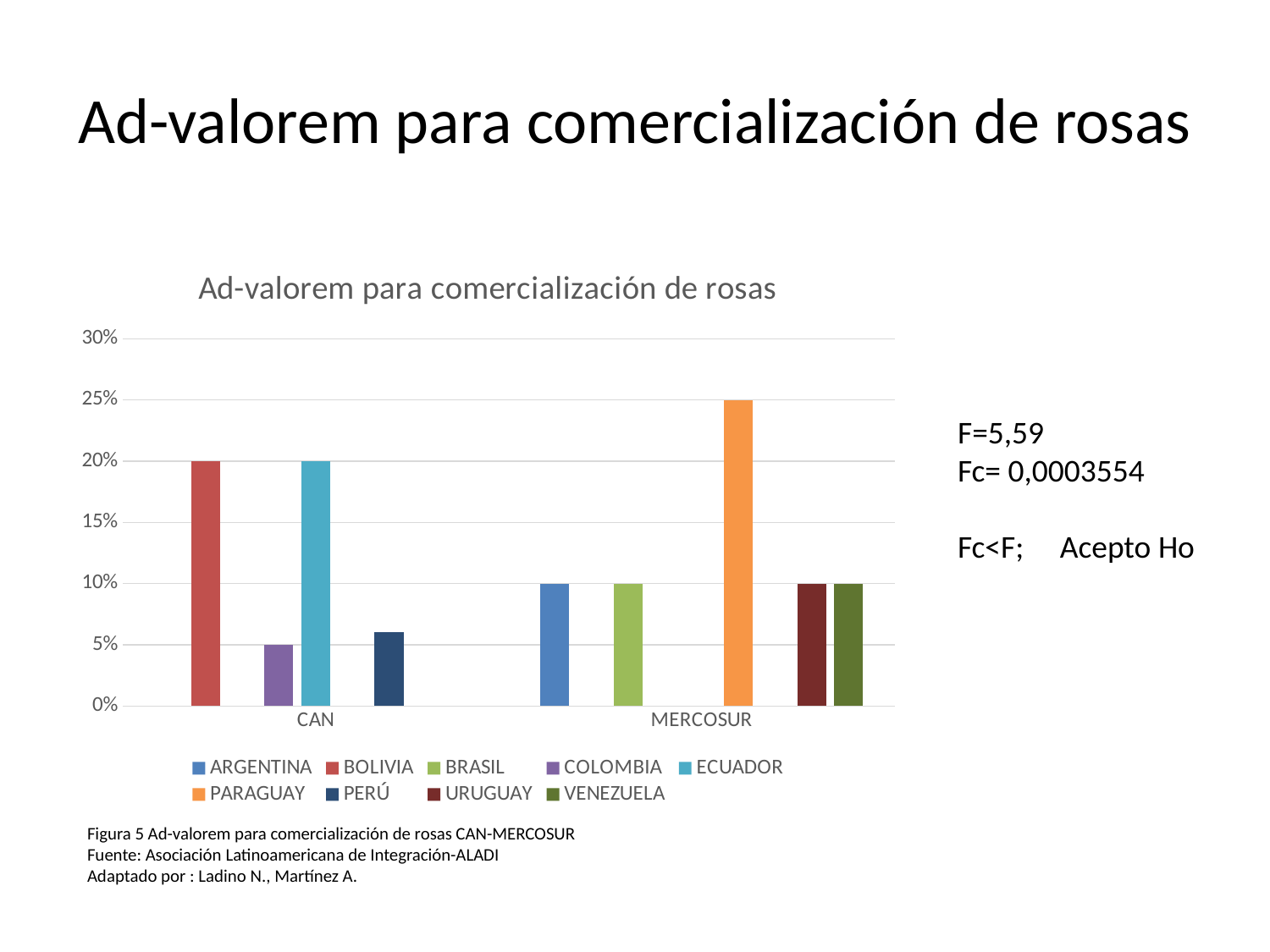
How many categories are shown on the x axis? 2 What kind of chart is shown on the slide? bar chart What is the ad-valorem value for COLOMBIA in the CAN group? 5% What is the difference between the values for PARAGUAY and BOLIVIA? 5% How many series does the legend list? 9 Which country has the highest ad-valorem value in the chart? PARAGUAY What is the title of the chart? Ad-valorem para comercialización de rosas Is the value for PERÚ greater or less than 10%? less What is the ad-valorem value for ECUADOR in the CAN group? 20% What is the ad-valorem value for PARAGUAY in the MERCOSUR group? 25% What is the ad-valorem value for BOLIVIA in the CAN group? 20% Which is larger, the value for BOLIVIA or the value for ARGENTINA? BOLIVIA